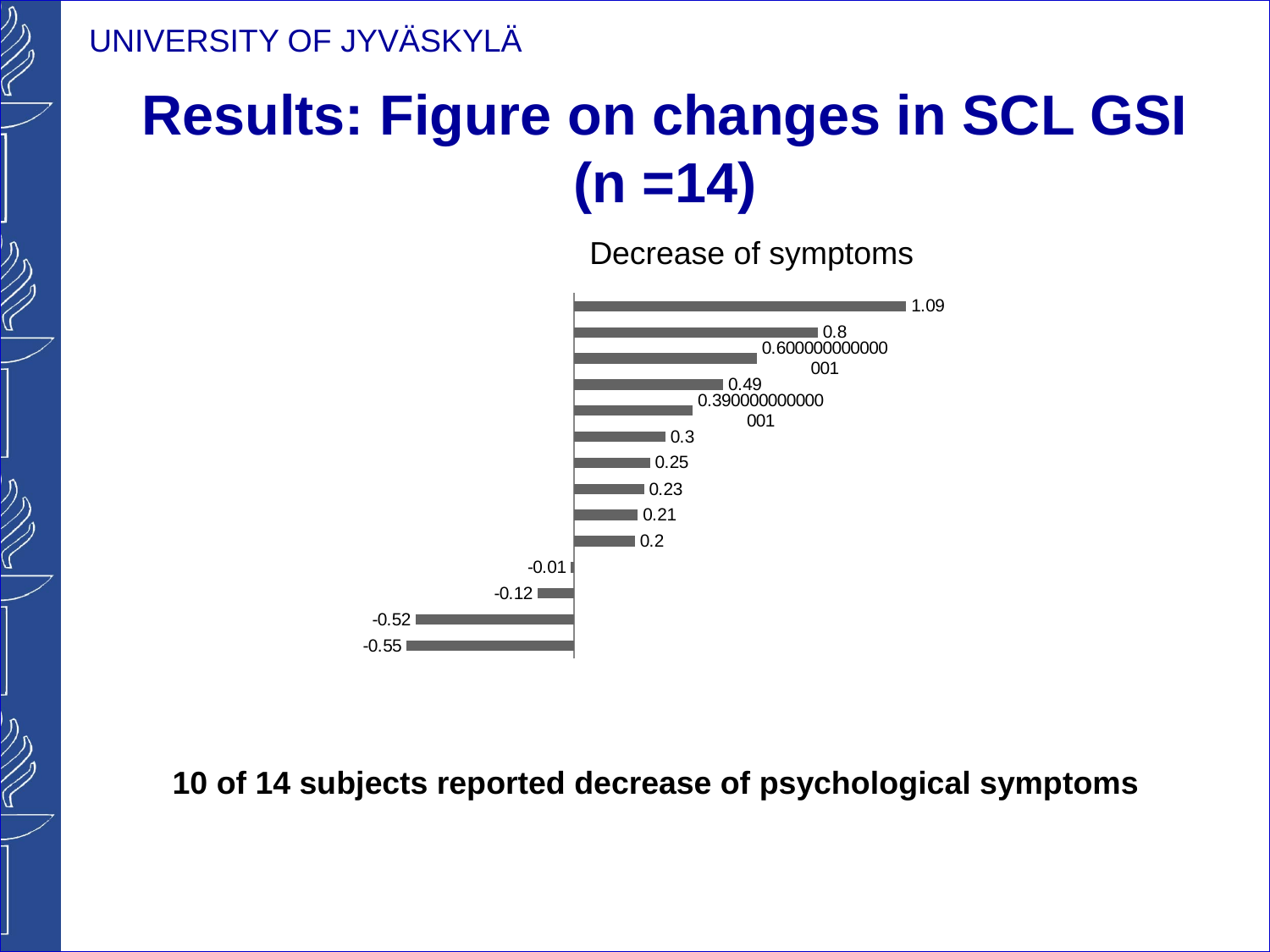
How many bars in the chart have positive values? 10 What is the lowest value shown in the chart? -0.55 What is the value labelled on the second bar from the top? 0.8 What is the title of the chart? Decrease of symptoms What is the value labelled on the bottom bar of the chart? -0.55 What is the difference between the highest value (1.09) and the second highest value (0.8)? 0.29 Which is larger, the value of the topmost bar (1.09) or the absolute value of the bottom bar (-0.55)? 1.09 What is the value labelled on the topmost bar of the chart? 1.09 What is the highest value shown in the chart? 1.09 How many bars in the chart have negative values? 4 How many bars are plotted in the chart? 14 What kind of chart is shown on the slide? bar chart